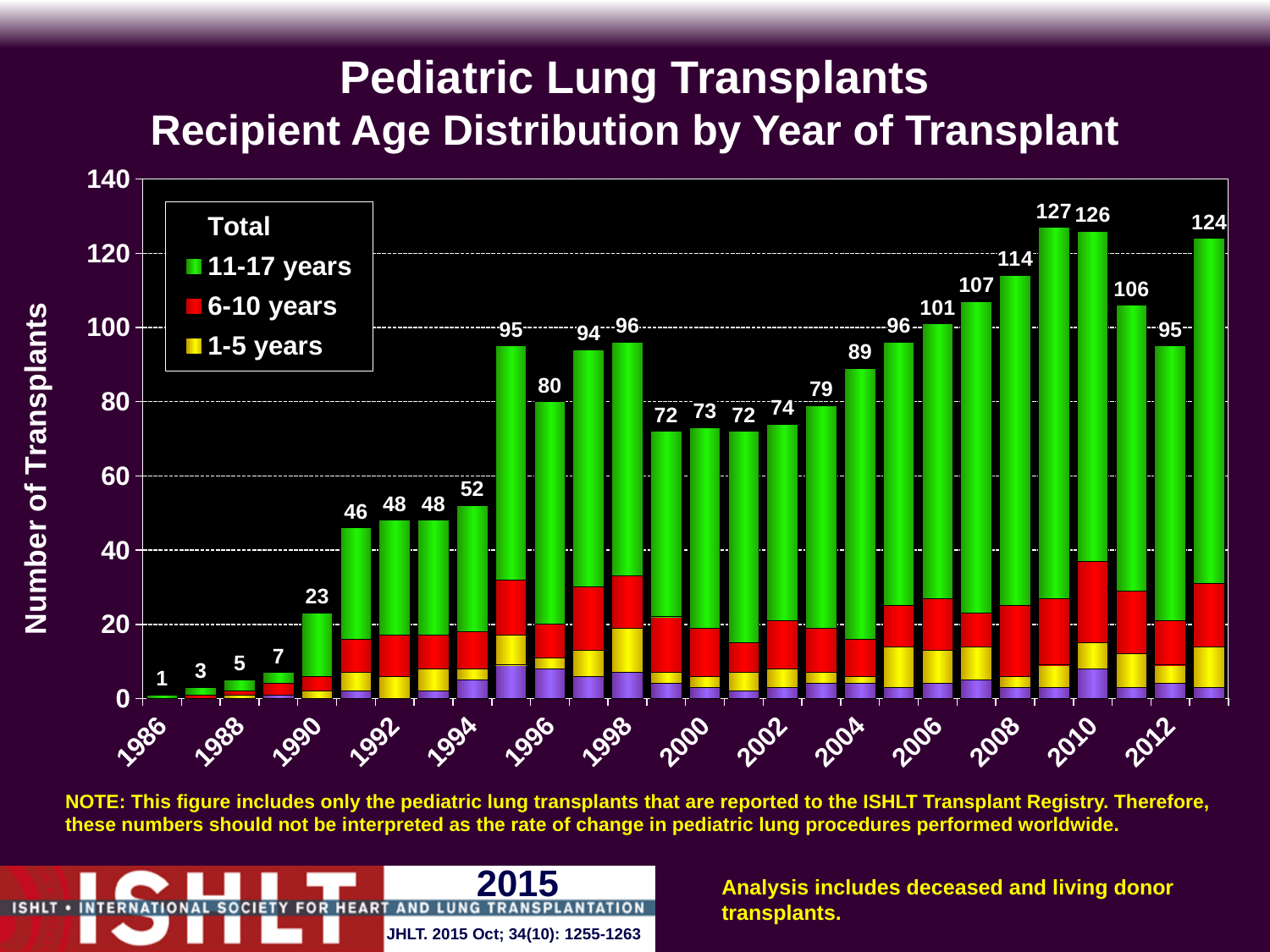
What is the difference between the total for 2009 and the total for 2010? 1 How many years (bars) are plotted on the chart? 28 Is the total for 2004 greater or less than 80? greater Do the totals rise or fall from 1986 to 1990? Rise What is the total number of pediatric lung transplants shown for 2009? 127 What is the total number of transplants shown for 2013? 124 Which year has a larger total, 2008 or 2011? 2008 What kind of chart is shown on the slide? Stacked bar chart Which year has the highest total number of transplants? 2009 What is the total number of transplants shown for 1990? 23 What is the difference between the total for 2013 and the total for 2012? 29 Which year has the lowest total number of transplants? 1986